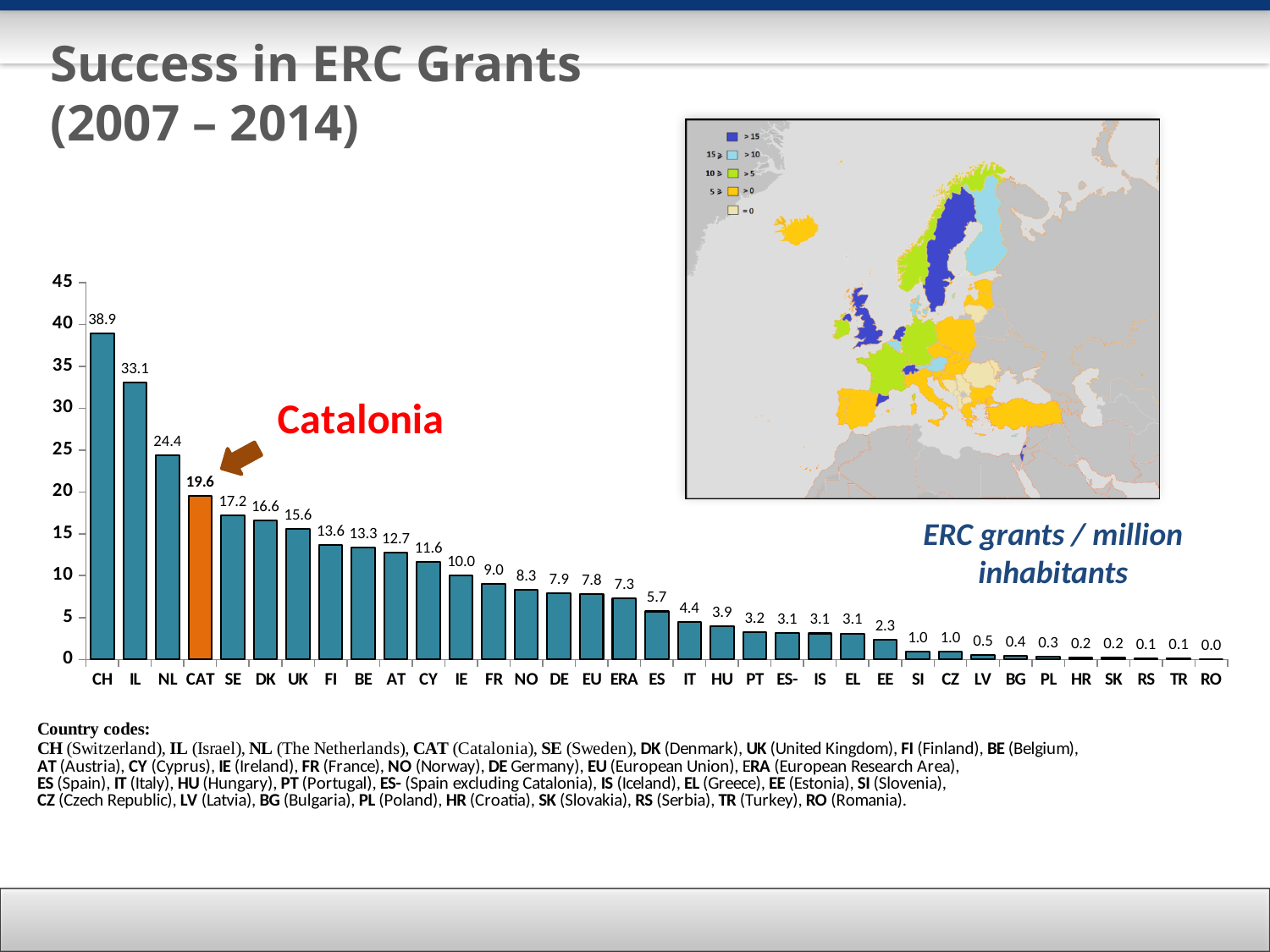
What is the value for CH (Switzerland) in the bar chart? 38.9 Is the value for UK in the bar chart greater or less than 20? less Which has a higher value in the bar chart, NL or SE? NL Which country has the highest value in the bar chart? CH What is the value for CAT (Catalonia) in the bar chart? 19.6 Which bar in the chart is highlighted in orange? CAT What is the difference between the values for CAT and ES in the bar chart? 13.9 How many countries or regions are shown on the x axis of the bar chart? 35 What type of chart is shown on the slide? bar chart What is the difference between the values for CH and IL in the bar chart? 5.8 Which country has the lowest value in the bar chart? RO What is the value for EU (European Union) in the bar chart? 7.8